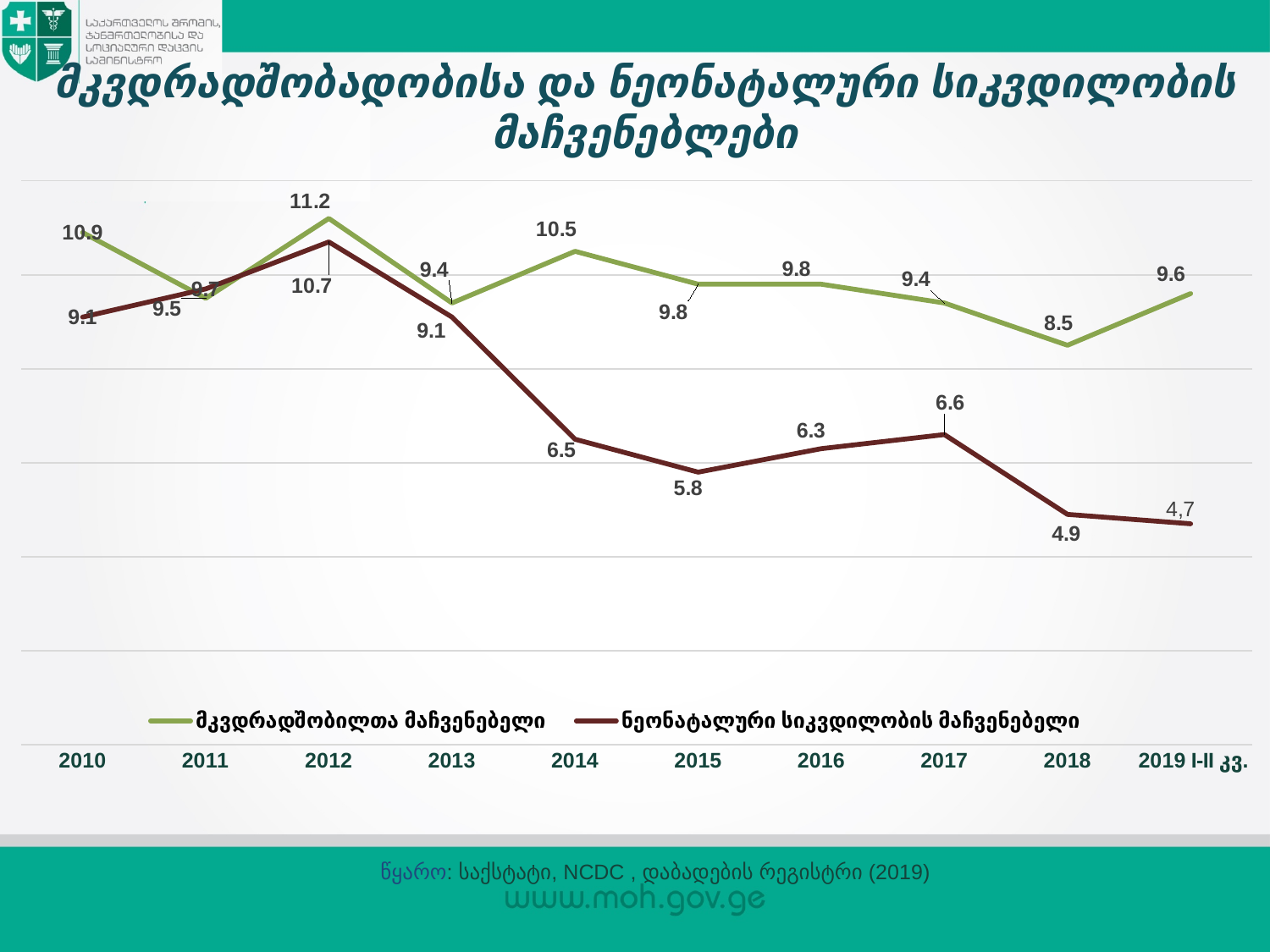
What is the neonatal mortality rate value for 2019 I-II კვ.? 4,7 Which is larger in 2014: the stillbirth rate or the neonatal mortality rate? the stillbirth rate In which year is the neonatal mortality rate (dark red line) lowest? 2019 I-II კვ. What is the stillbirth rate (მკვდრადშობილთა მაჩვენებელი) value for 2012? 11.2 In which year is the stillbirth rate (green line) highest? 2012 How many series does the legend list? 2 Does the neonatal mortality rate rise or fall from 2017 to 2018? fall How many time points are shown on the x axis? 10 What is the stillbirth rate value for 2018? 8.5 What kind of chart is shown on the slide? line chart What is the neonatal mortality rate (ნეონატალური სიკვდილობის მაჩვენებელი) value for 2015? 5.8 What is the difference between the stillbirth rate and the neonatal mortality rate in 2018? 3.6